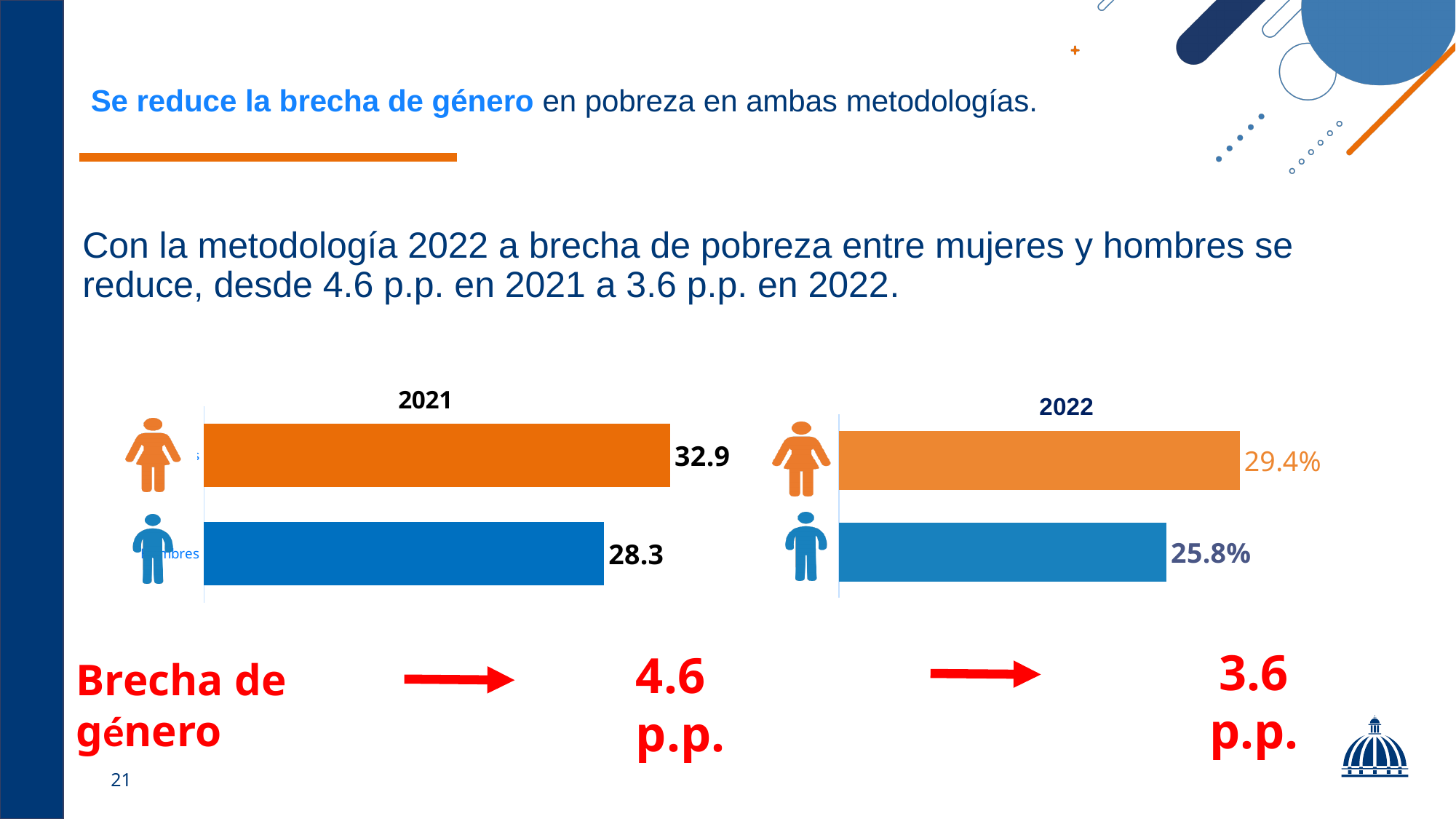
In the 2022 chart, what is the difference between the women's and men's values? 3.6 In the 2021 chart, what is the value for women (the bar with the female icon)? 32.9 How many bars does the 2022 chart show? 2 In the 2022 chart, what is the value for men (the bar with the male icon)? 25.8% In the 2021 chart, what is the value for men (the bar with the male icon)? 28.3 In the 2021 chart, which group has the higher value, women or men? Women In the 2022 chart, what is the value for women (the bar with the female icon)? 29.4% What is the title of the chart on the right side of the slide? 2022 In the 2021 chart, what is the difference between the women's and men's values? 4.6 What type of chart is the 2021 chart? Bar chart In the 2021 chart, what colour is the bar for women? Orange In the 2022 chart, which bar is the lowest? Men